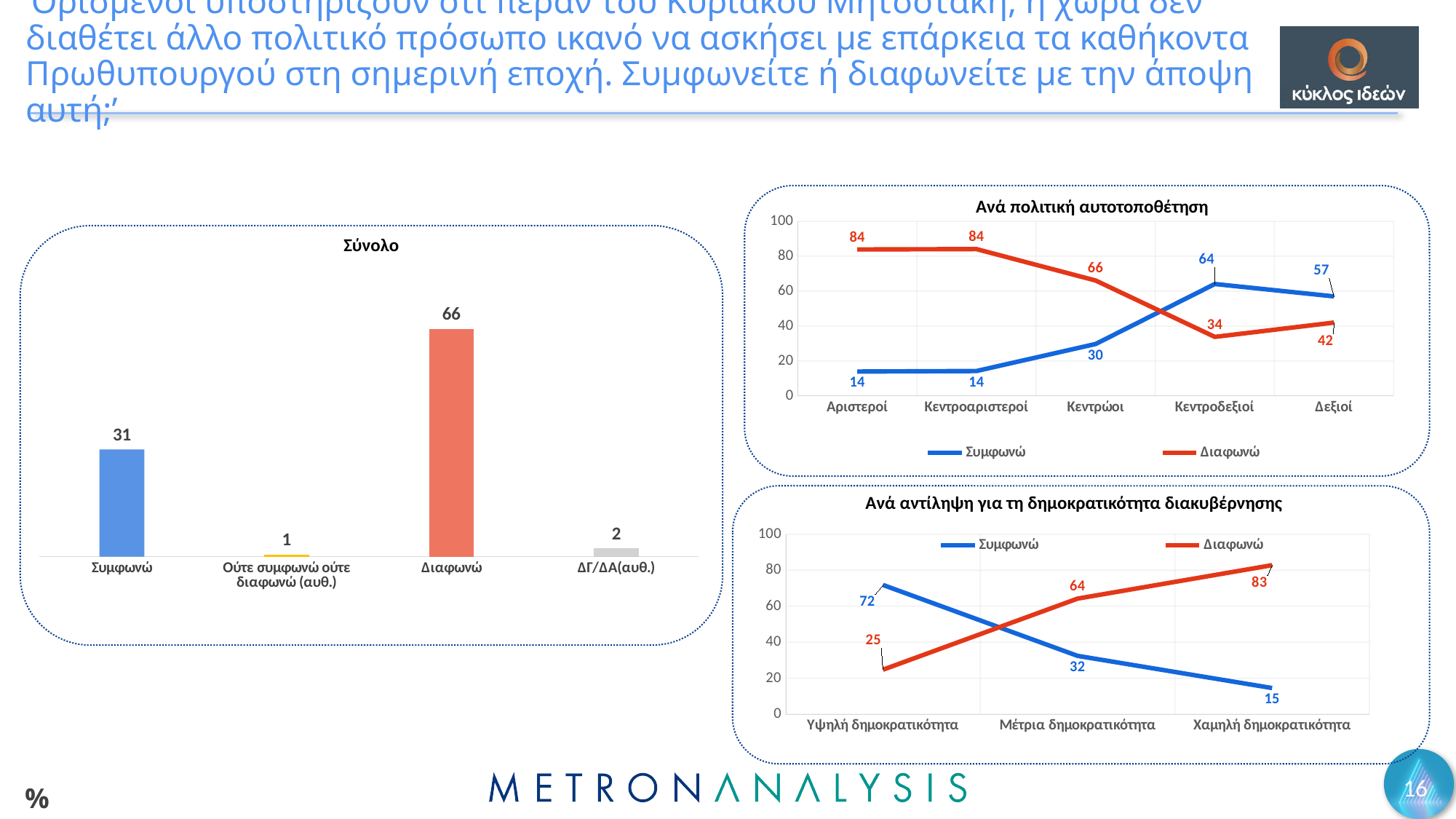
In the 'Σύνολο' chart, which category has the lowest value? Ούτε συμφωνώ ούτε διαφωνώ (αυθ.) In the 'Σύνολο' chart, what is the difference between Διαφωνώ and Συμφωνώ? 35 In the 'Ανά πολιτική αυτοτοποθέτηση' chart, what is the Διαφωνώ value for Κεντρώοι? 66 In the 'Σύνολο' chart, what is the value for Διαφωνώ? 66 In the 'Ανά πολιτική αυτοτοποθέτηση' chart, what is the Συμφωνώ value for Κεντροδεξιοί? 64 What kind of chart is the 'Σύνολο' chart? Bar chart In the 'Ανά πολιτική αυτοτοποθέτηση' chart, does the Συμφωνώ line rise or fall from Αριστεροί to Κεντροδεξιοί? Rise In the 'Σύνολο' chart, how many categories are shown? 4 In the 'Ανά αντίληψη για τη δημοκρατικότητα διακυβέρνησης' chart, what is the Διαφωνώ value for Χαμηλή δημοκρατικότητα? 83 In the 'Ανά αντίληψη για τη δημοκρατικότητα διακυβέρνησης' chart, which is larger for Υψηλή δημοκρατικότητα: Συμφωνώ or Διαφωνώ? Συμφωνώ In the 'Ανά πολιτική αυτοτοποθέτηση' chart, how many series does the legend list? 2 In the 'Σύνολο' chart, which category has the highest value? Διαφωνώ